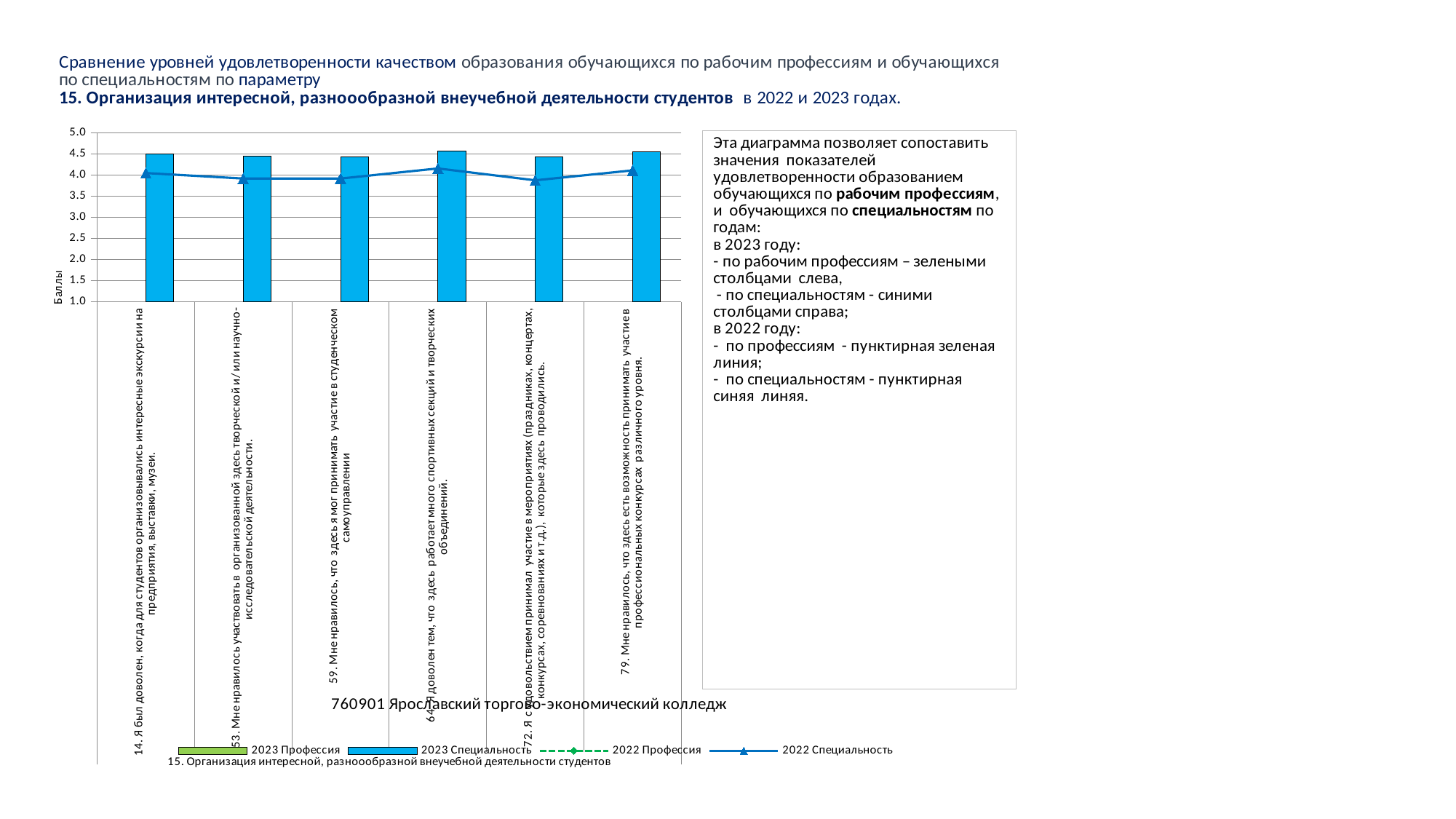
What kind of chart is shown on the slide? Bar chart combined with a line Is the 2023 Специальность bar for statement 64 greater or less than 4.0? greater Is the 2022 Специальность line value for statement 72 greater or less than 4.5? less Is the 2022 Специальность line value for statement 53 greater or less than 3.5? greater For statement 14, which is larger: the 2023 Специальность bar or the 2022 Специальность line value? 2023 Специальность bar Which legend entry corresponds to the blue bars? 2023 Специальность For statement 72, which is larger: the 2023 Специальность bar or the 2022 Специальность line value? 2023 Специальность bar How many categories (survey statements) are shown along the x axis of the chart? 6 What is the label of the vertical axis of the chart? Баллы How many series does the chart legend list? 4